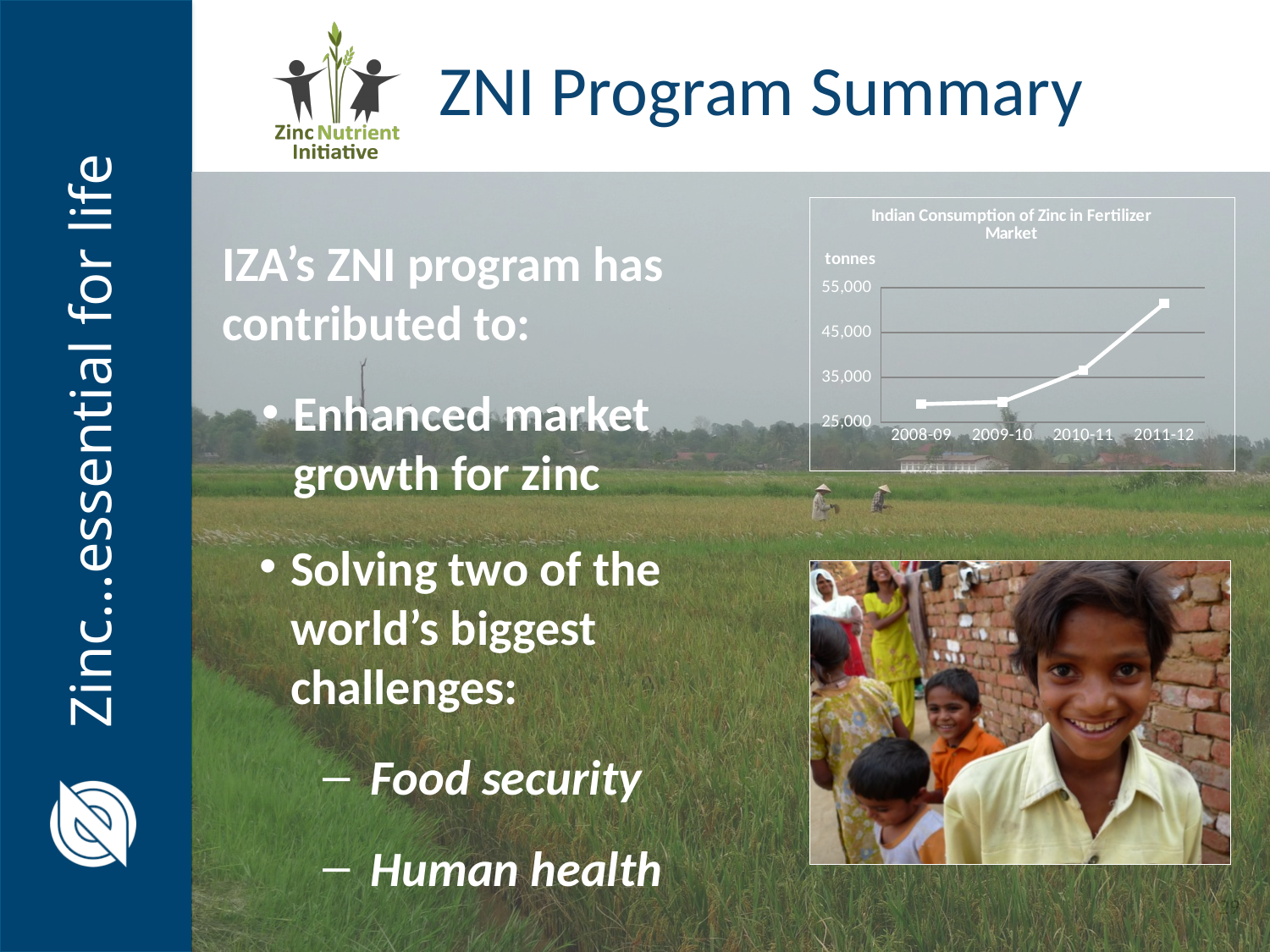
Is the value for 2011-12 greater or less than 45,000? greater Do the values in the chart rise or fall from 2008-09 to 2011-12? rise What is the title of the chart on the slide? Indian Consumption of Zinc in Fertilizer Market What unit is shown on the vertical axis of the chart? tonnes Is the value for 2010-11 greater or less than 45,000? less What kind of chart is shown on the slide? line chart Which period has the highest zinc consumption in the chart? 2011-12 How many time periods are plotted on the x axis of the chart? 4 Is the value for 2010-11 greater or less than 35,000? greater Which is larger, the value for 2011-12 or the value for 2010-11? 2011-12 Which is larger, the value for 2010-11 or the value for 2009-10? 2010-11